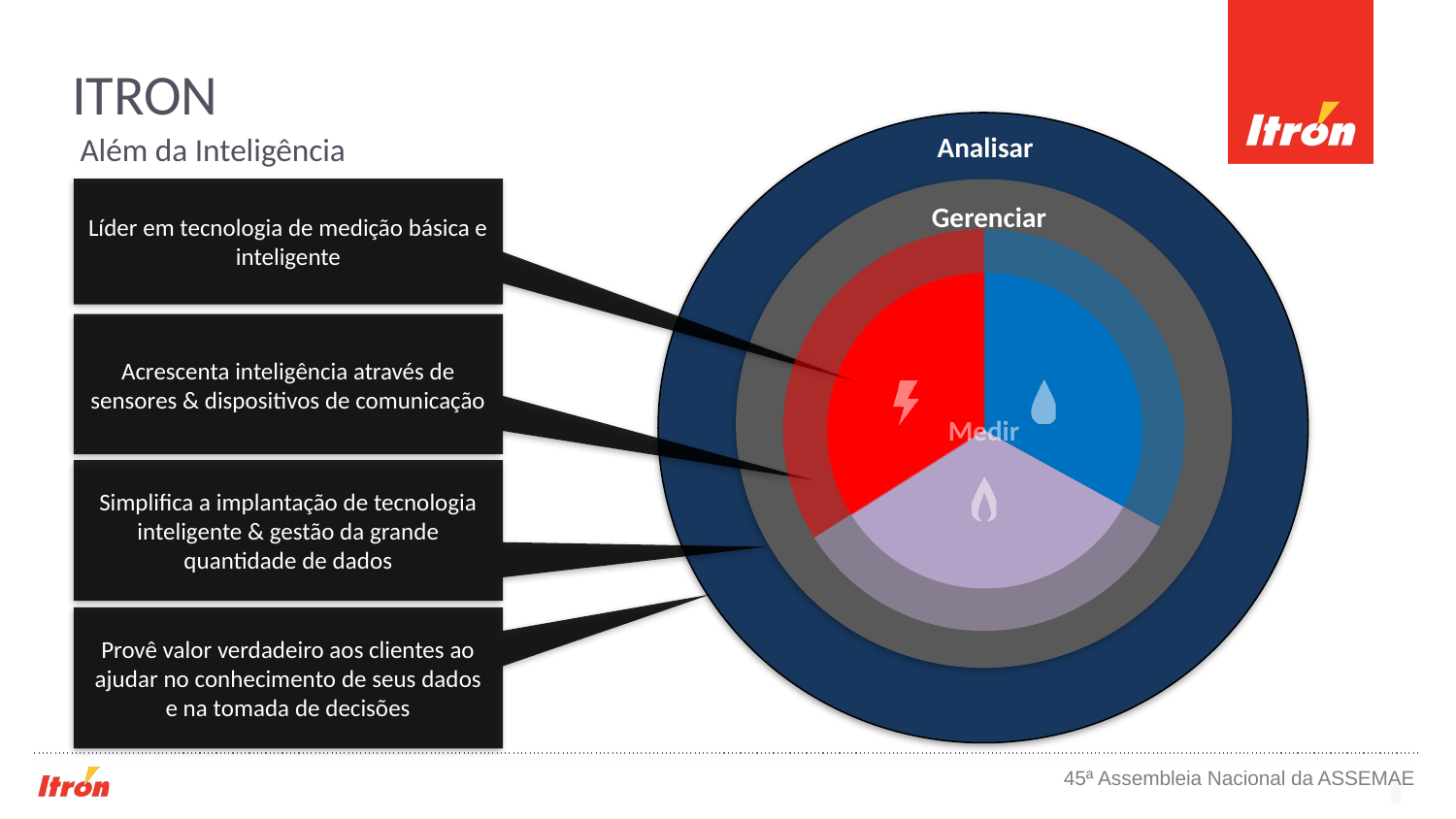
What label appears at the centre of the circular diagram? Medir What is the label on the outermost ring of the circular diagram? Analisar How many segments is the central circle of the diagram divided into? 3 What colour is the segment of the central circle that contains the water-drop icon? Blue How many black text boxes point to the circular diagram? 4 What is the label on the middle ring of the circular diagram? Gerenciar What colour is the segment of the central circle that contains the lightning-bolt icon? Red